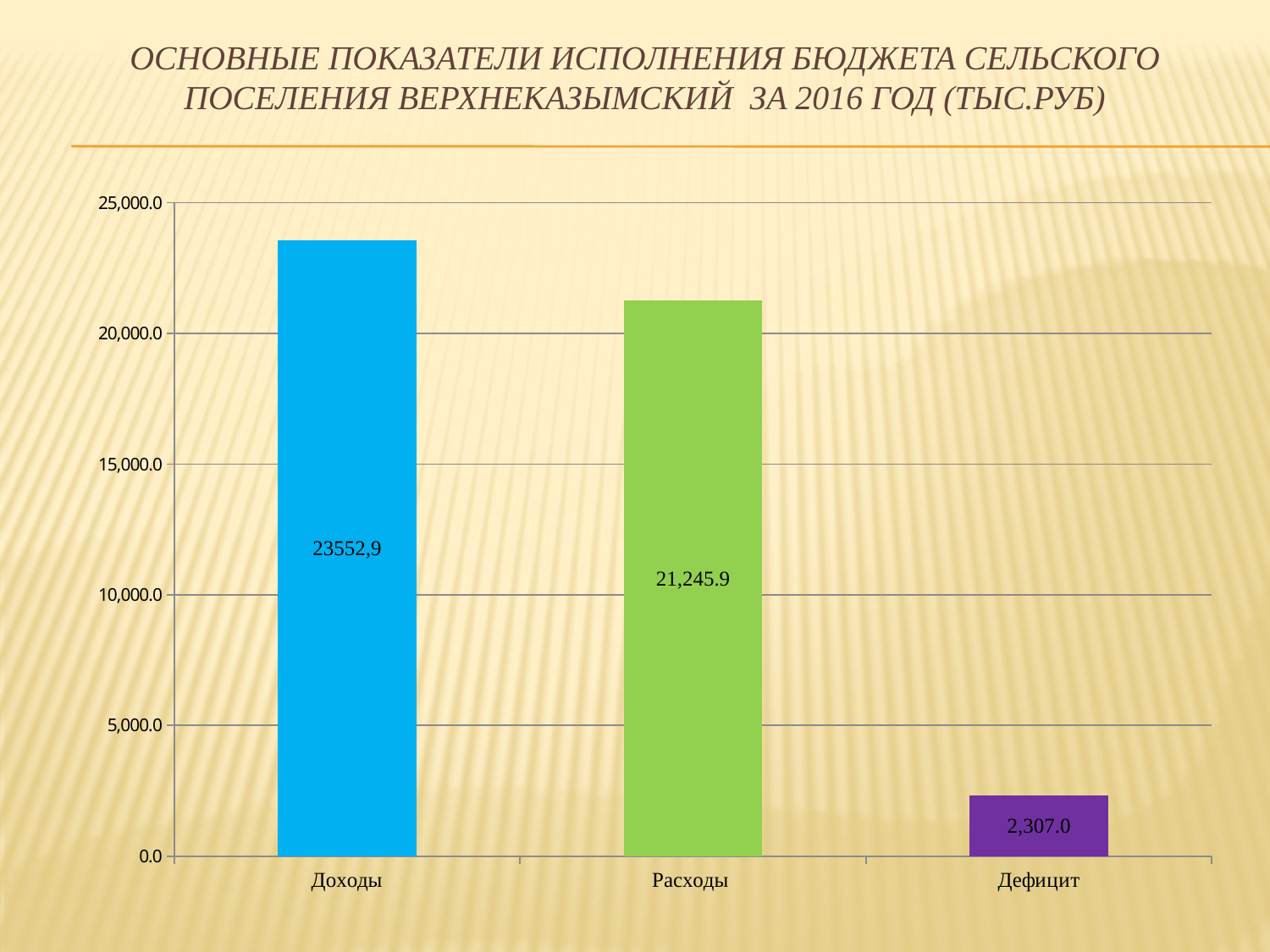
What colour is the bar for Дефицит? purple Is the value for Расходы greater or less than 20,000.0? greater What value is shown for Доходы? 23552,9 What kind of chart is shown on the slide? bar chart Is the value for Дефицит greater or less than 5,000.0? less Which category has the lowest value? Дефицит How many categories are shown on the x axis? 3 Which is larger, Доходы or Расходы? Доходы Which category has the highest value? Доходы What value is shown for Дефицит? 2,307.0 What is the difference between Доходы and Расходы? 2,307.0 What value is shown for Расходы? 21,245.9